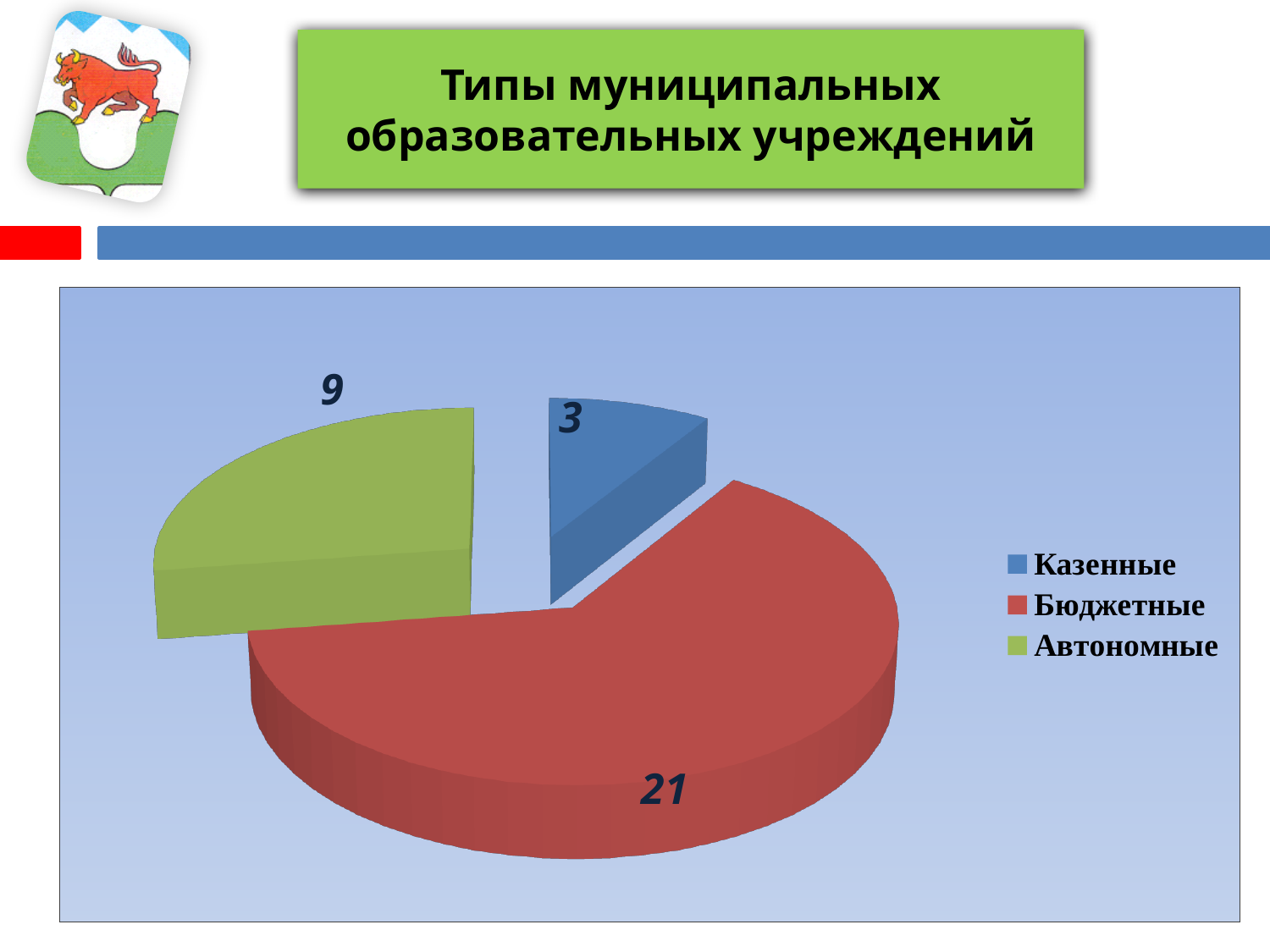
What is the total of all slices in the pie chart? 33 What type of chart is shown on the slide? pie chart Which is larger, Автономные or Казенные? Автономные What is the title of the slide containing the chart? Типы муниципальных образовательных учреждений What is the difference between the values for Автономные and Казенные? 6 Which category has the largest slice? Бюджетные How many slices does the pie chart have? 3 What is the value for Казенные? 3 Which category has the smallest slice? Казенные What is the value for Бюджетные? 21 What is the value for Автономные? 9 What is the difference between the values for Бюджетные and Автономные? 12